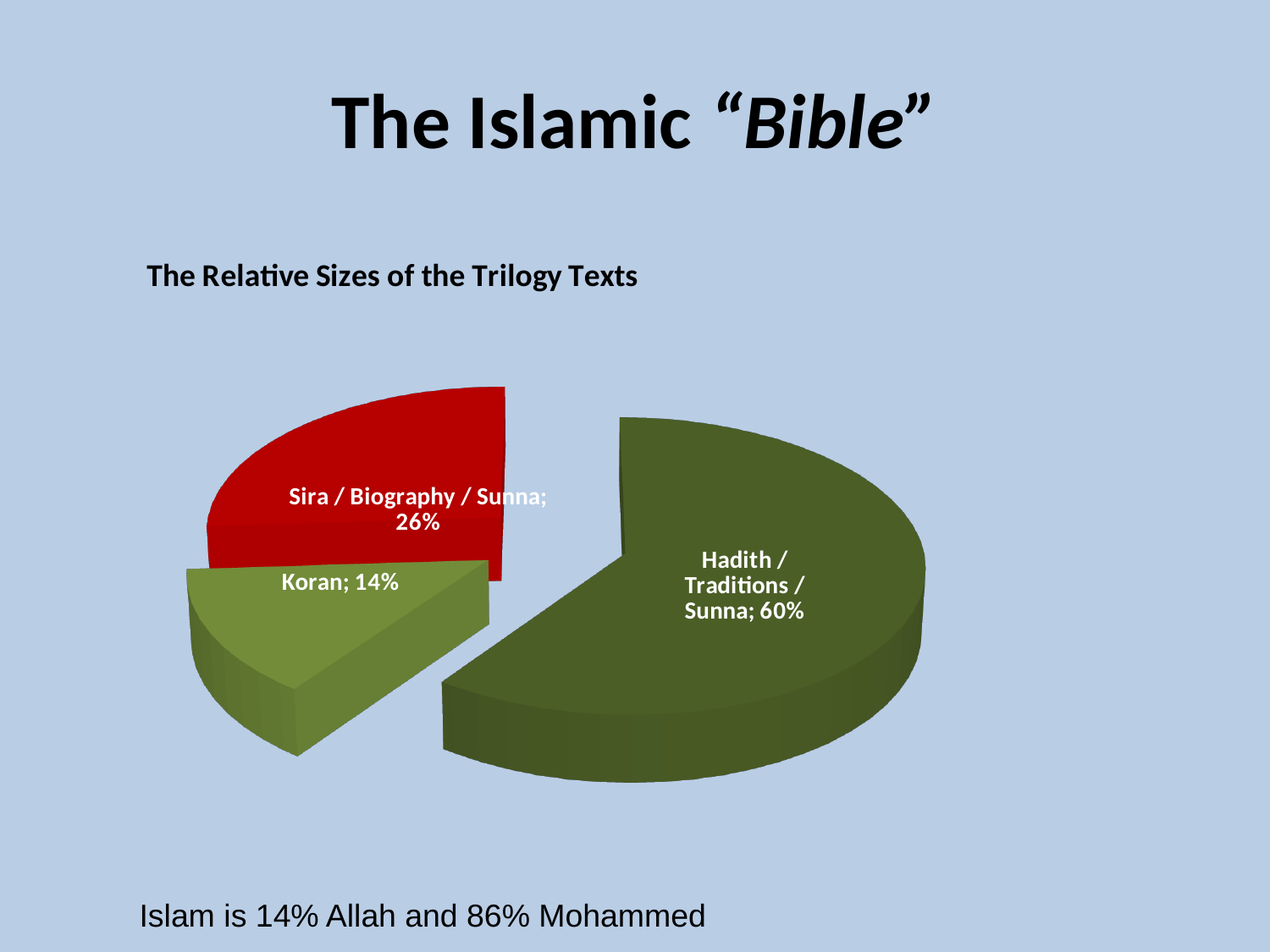
What kind of chart is shown on the slide? Pie chart What is the difference in percentage points between the Hadith / Traditions / Sunna slice and the Sira / Biography / Sunna slice? 34 What percentage does the Koran slice represent? 14% What is the title of the chart? The Relative Sizes of the Trilogy Texts How many slices does the pie chart have? 3 What is the difference in percentage points between the Sira / Biography / Sunna slice and the Koran slice? 12 Which slice of the pie is the smallest? Koran What percentage does the Sira / Biography / Sunna slice represent? 26% Which slice of the pie is the largest? Hadith / Traditions / Sunna What colour is the Sira / Biography / Sunna slice? Red What percentage does the Hadith / Traditions / Sunna slice represent? 60% Which is larger, the Koran slice or the Sira / Biography / Sunna slice? Sira / Biography / Sunna